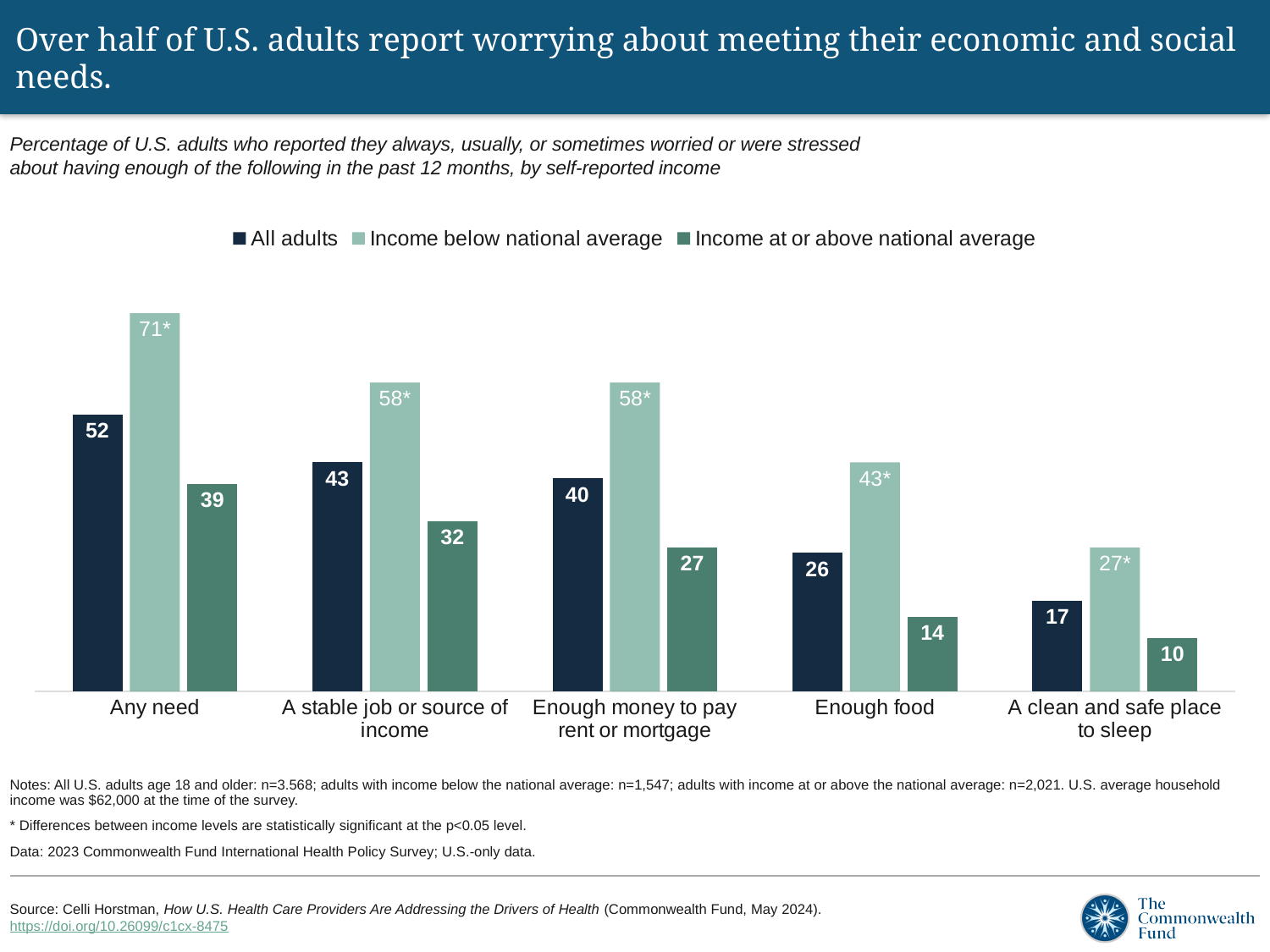
What is the value for All adults in the Any need category? 52 What is the difference between the All adults values for A stable job or source of income and Enough money to pay rent or mortgage? 3 Which is larger: the All adults value for Enough food or the All adults value for A clean and safe place to sleep? Enough food What kind of chart is shown on the slide? Bar chart Which category has the highest value for Income below national average? Any need What is the value for Income at or above national average in the A clean and safe place to sleep category? 10 What is the difference between the Income below national average and Income at or above national average values in the Any need category? 32 How many series does the legend list? 3 Do the All adults values rise or fall from left to right across the categories? Fall What is the value for Income below national average in the Enough food category? 43* Which category has the lowest value for All adults? A clean and safe place to sleep How many categories are shown on the x axis? 5